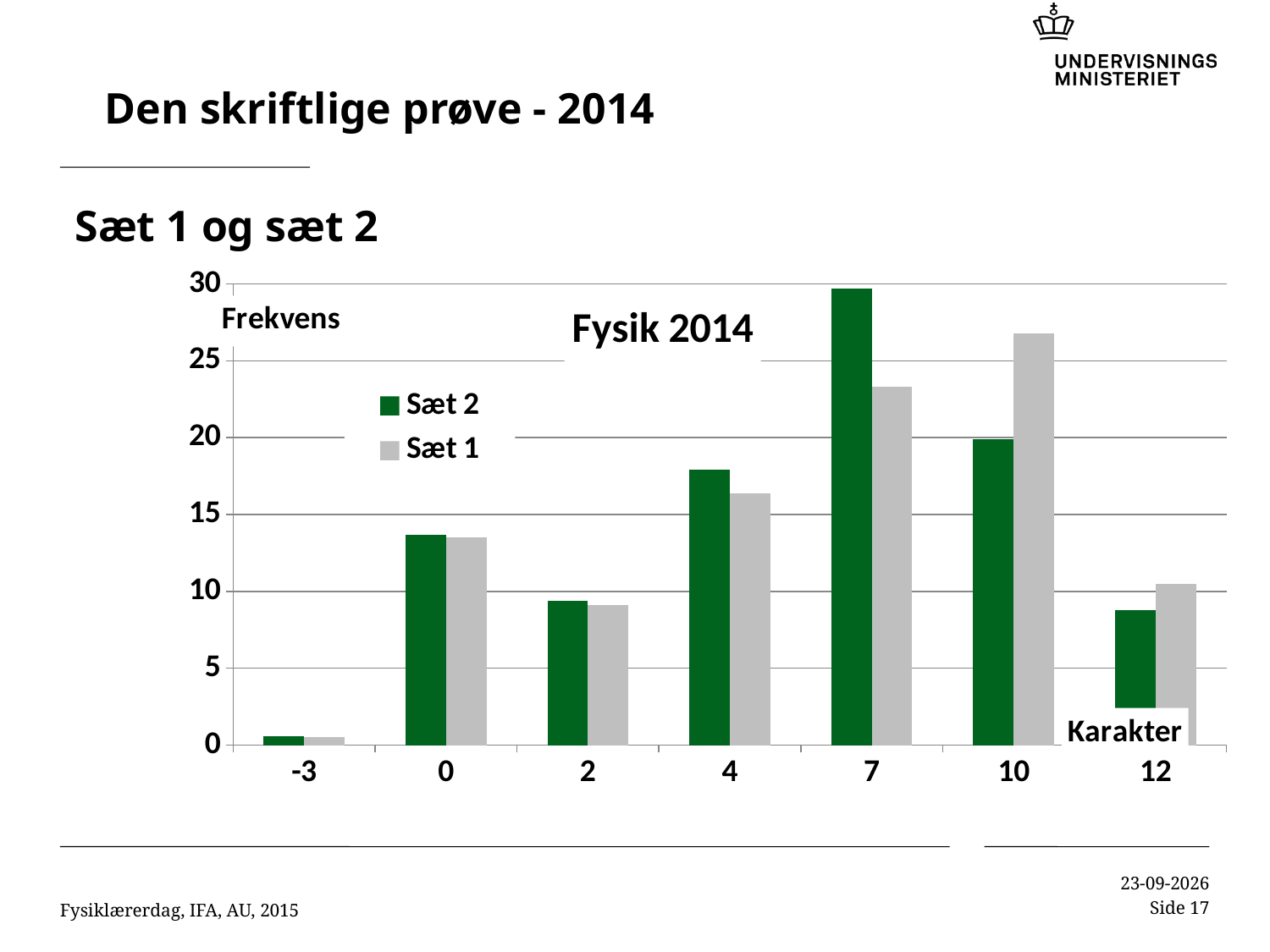
For which Karakter is the Sæt 2 value lowest? -3 What kind of chart is shown on the slide? bar chart How many series does the chart's legend list? 2 Is the Sæt 2 value for Karakter 7 greater or less than 25? greater At Karakter 10, which series has the larger value, Sæt 1 or Sæt 2? Sæt 1 For which Karakter is the Sæt 2 value highest? 7 Which series is shown in green? Sæt 2 At Karakter 7, which series has the larger value, Sæt 1 or Sæt 2? Sæt 2 How many categories (Karakter values) are shown on the x axis? 7 What is the title of the chart? Fysik 2014 For which Karakter is the Sæt 1 value highest? 10 Is the Sæt 1 value for Karakter 12 greater or less than 15? less